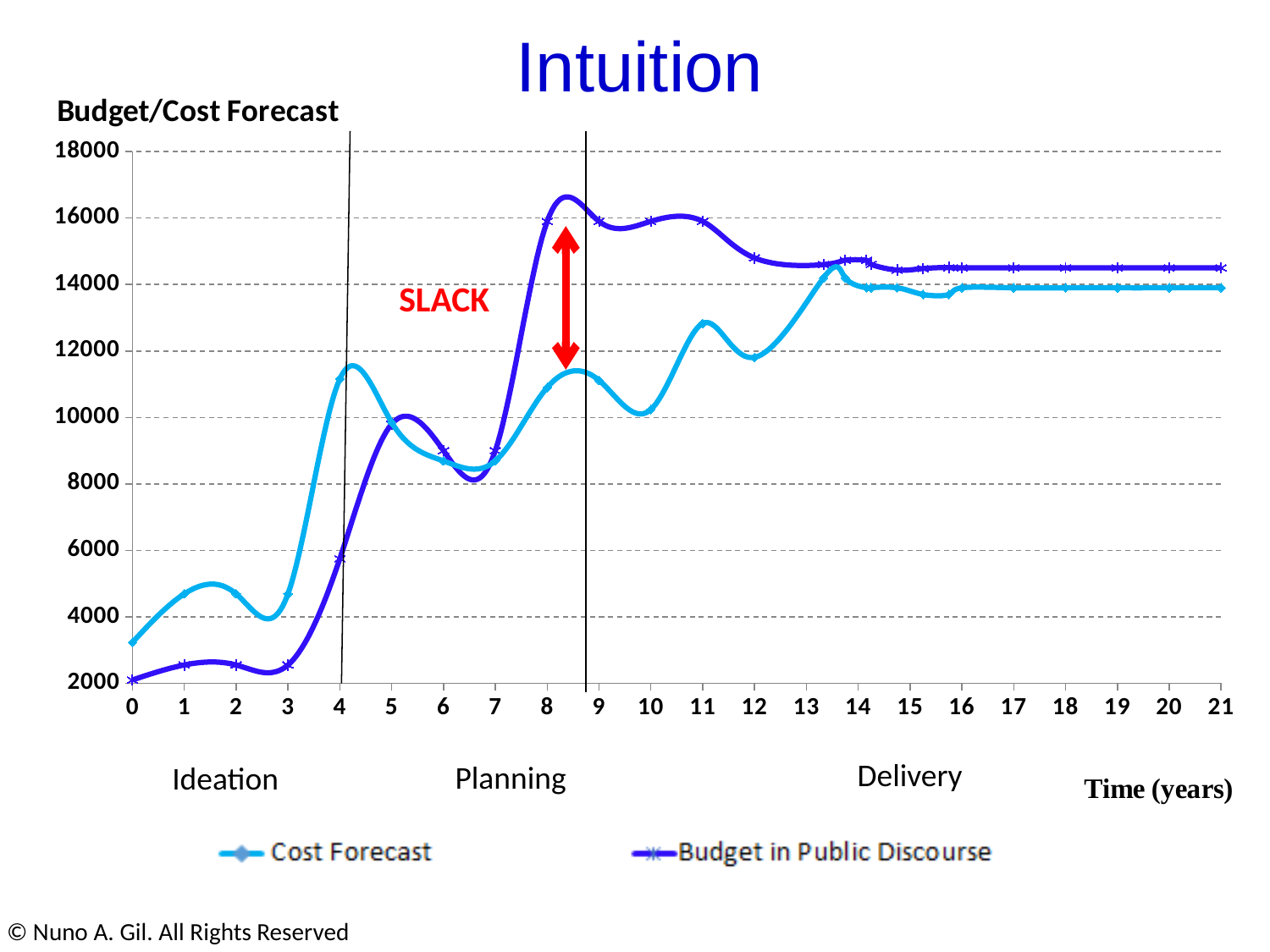
Does the Budget in Public Discourse series rise or fall between year 0 and year 8? rise Which series reaches the highest value anywhere on the chart? Budget in Public Discourse How many series does the legend list? 2 At year 8, which series has the higher value, Cost Forecast or Budget in Public Discourse? Budget in Public Discourse Is the Budget in Public Discourse value at year 1 greater or less than 4000? less Is the Budget in Public Discourse value at year 21 greater or less than 14000? greater Is the Cost Forecast value at year 4 greater or less than 10000? greater What kind of chart is shown on the slide? line chart What are the three phases labelled along the x axis? Ideation, Planning, Delivery At year 4, which series has the higher value, Cost Forecast or Budget in Public Discourse? Cost Forecast What are the two series named in the legend? Cost Forecast and Budget in Public Discourse